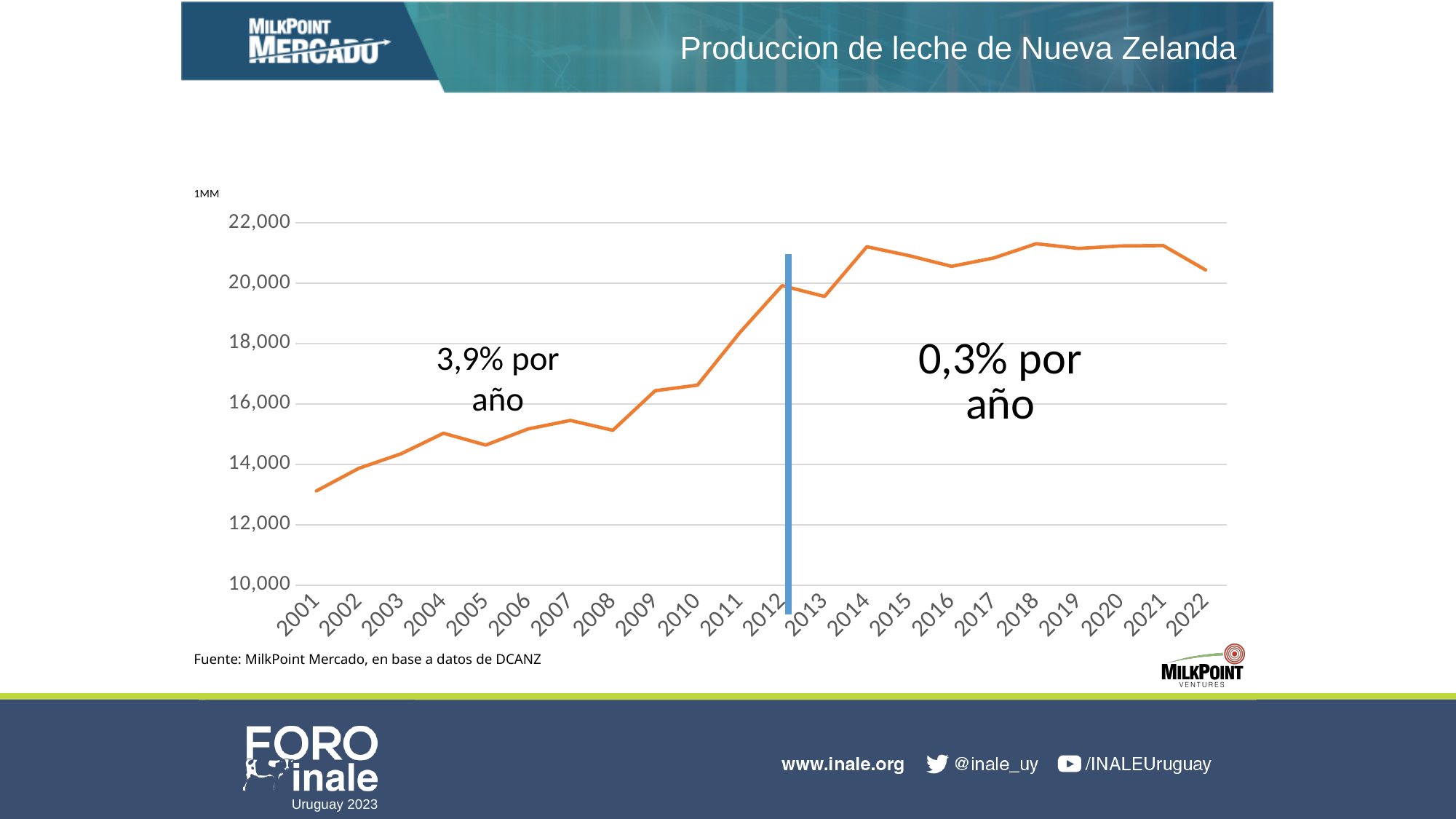
Is the value for 2016 greater or less than 20,000? greater Which year has the larger value, 2012 or 2013? 2012 What kind of chart is shown on the slide? line chart What annual growth rate is annotated for the period before the vertical blue line? 3,9% por año What is the title of the chart? Produccion de leche de Nueva Zelanda Is the value for 2008 greater or less than 16,000? less Is the value for 2001 greater or less than 14,000? less Overall, do the values rise or fall from 2001 to 2022? rise How many years are plotted along the x axis? 22 Which year has the lowest milk production value? 2001